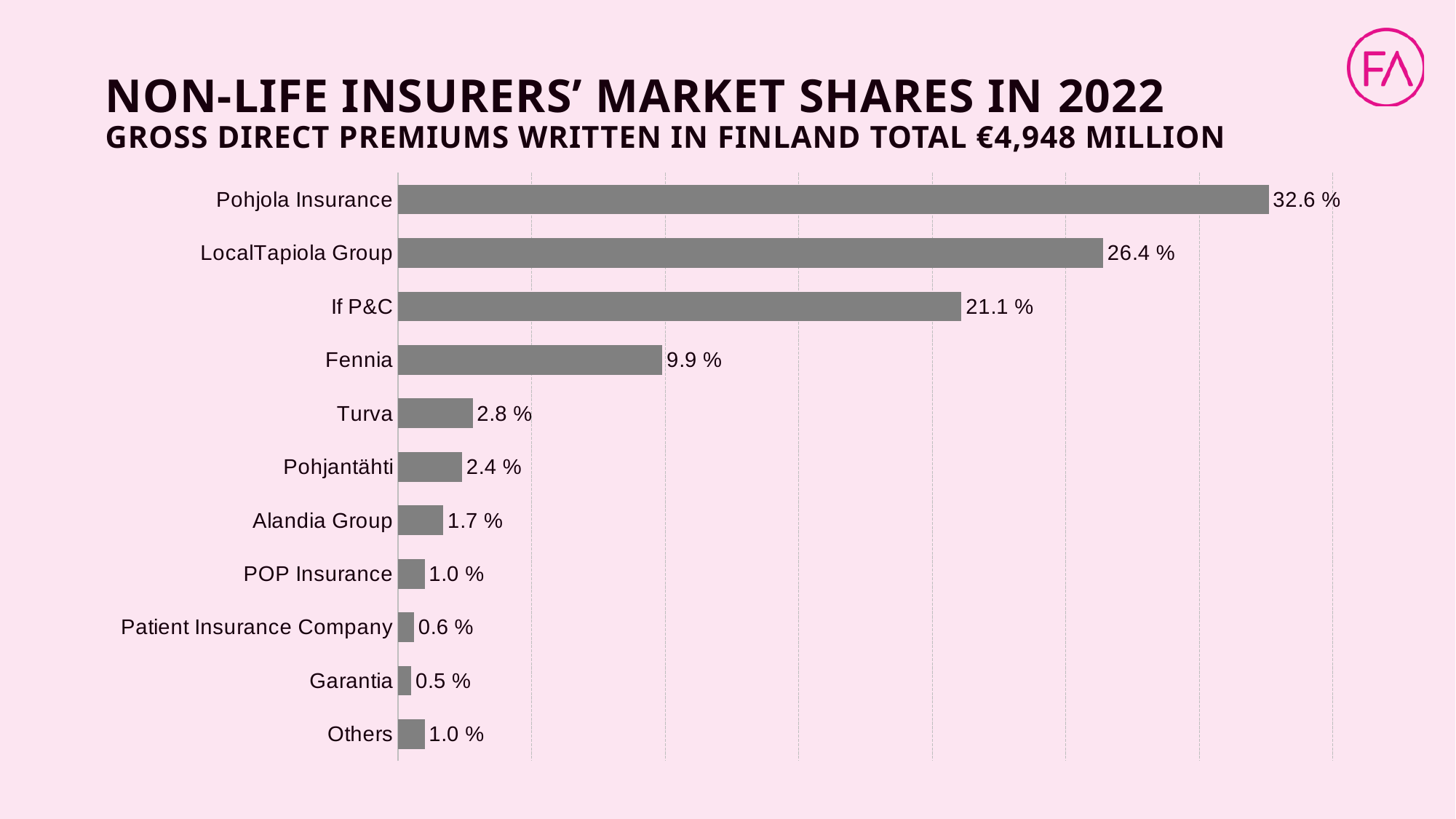
What is the difference in market share between Pohjola Insurance and LocalTapiola Group? 6.2 % Which has a larger market share, Turva or Pohjantähti? Turva What type of chart is shown on the slide? Bar chart What is the market share of Fennia? 9.9 % Which insurer has the largest market share? Pohjola Insurance What is the total of gross direct premiums written in Finland stated in the subtitle? €4,948 million What is the market share of Pohjola Insurance? 32.6 % What is the market share of Alandia Group? 1.7 % How many categories are shown in the chart? 11 Which insurer has the smallest market share? Garantia What is the difference in market share between If P&C and Fennia? 11.2 % What is the market share of Patient Insurance Company? 0.6 %